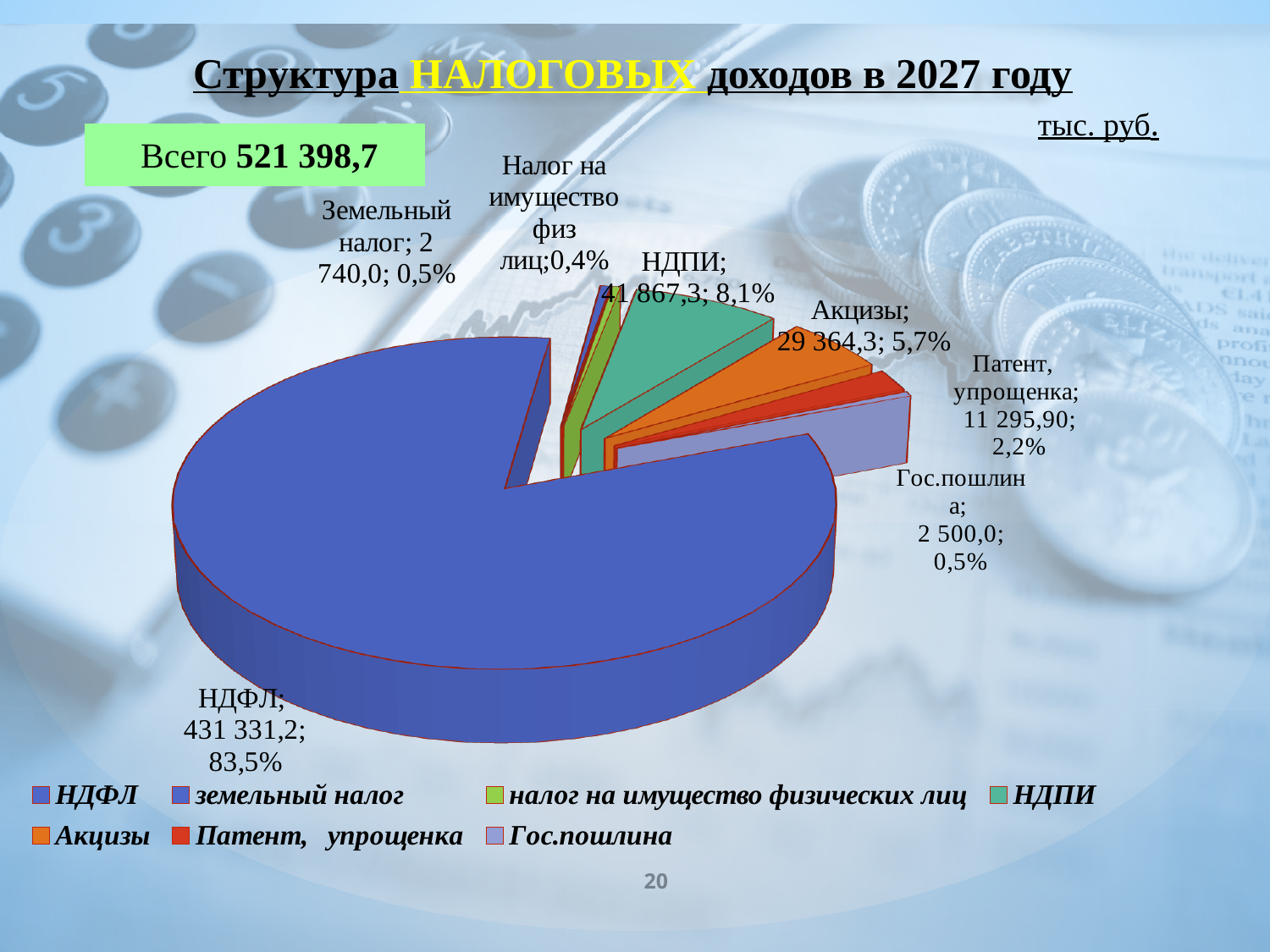
What share of the pie does Налог на имущество физ лиц take? 0,4% What is the difference between the values for НДПИ and Акцизы? 12 503,0 What share of the pie does НДФЛ take? 83,5% Which is larger, НДПИ or Акцизы? НДПИ What kind of chart is shown on the slide? pie chart What share of the pie does Акцизы take? 5,7% How many entries does the legend list? 7 Which category has the smallest slice? Налог на имущество физ лиц What is the value for Патент, упрощенка? 11 295,90 What is the value for НДФЛ? 431 331,2 Which category has the largest slice? НДФЛ What is the value for НДПИ? 41 867,3